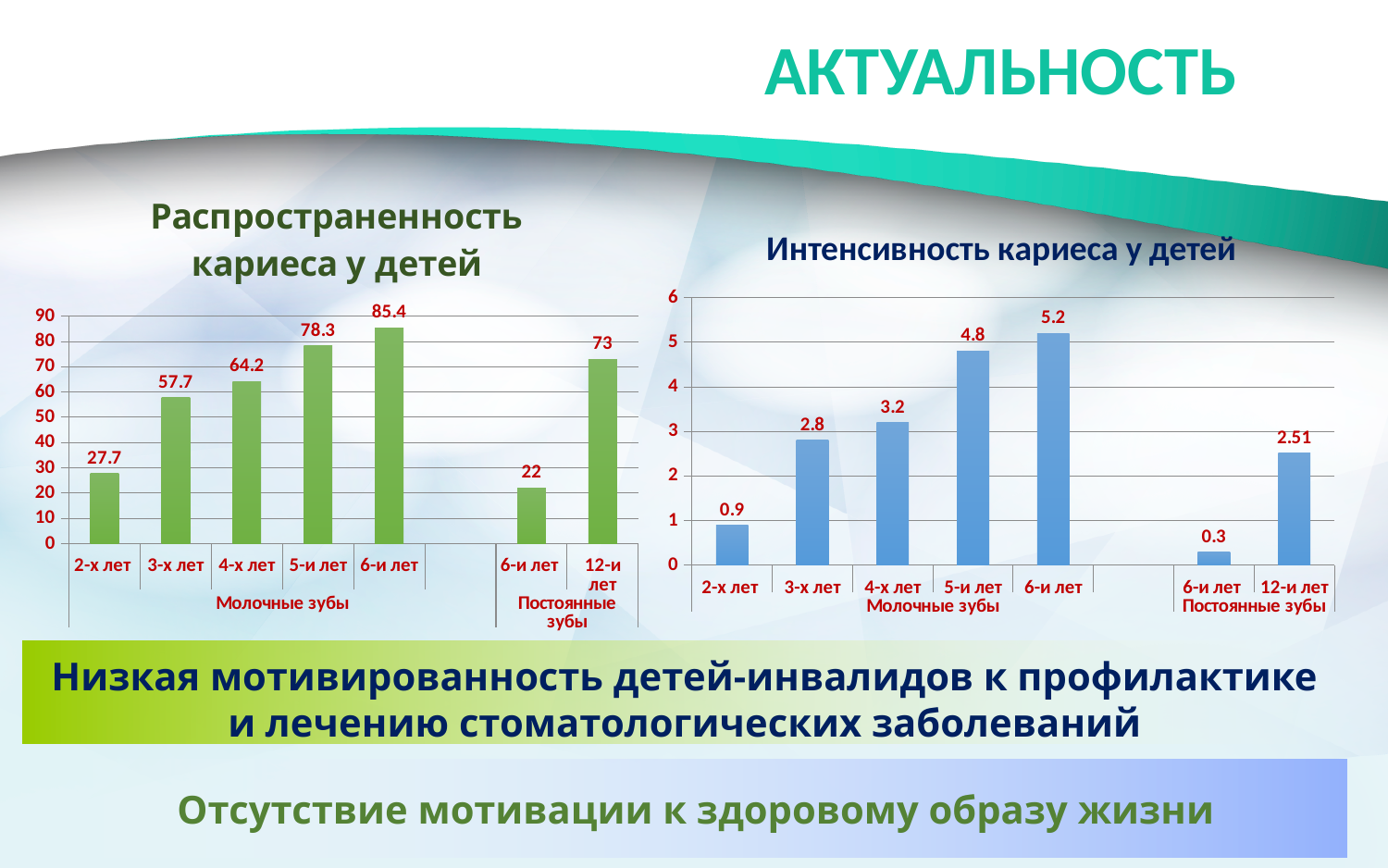
In the chart 'Распространенность кариеса у детей', which category has the highest value? 6-и лет (Молочные зубы) In the chart 'Распространенность кариеса у детей', what is the value for 4-х лет (Молочные зубы)? 64.2 What type of chart is 'Интенсивность кариеса у детей'? bar chart In the chart 'Распространенность кариеса у детей', which category has the lowest value? 6-и лет (Постоянные зубы) In the chart 'Распространенность кариеса у детей', how many bars are plotted? 7 In the chart 'Распространенность кариеса у детей', do the values for Молочные зубы rise or fall from 2-х лет to 6-и лет? rise In the chart 'Интенсивность кариеса у детей', which category has the lowest value? 6-и лет (Постоянные зубы) In the chart 'Интенсивность кариеса у детей', what is the value for 12-и лет (Постоянные зубы)? 2.51 In the chart 'Интенсивность кариеса у детей', what is the difference between the values for 6-и лет and 2-х лет (Молочные зубы)? 4.3 In the chart 'Распространенность кариеса у детей', what is the difference between the values for 12-и лет (Постоянные зубы) and 6-и лет (Постоянные зубы)? 51 In the chart 'Интенсивность кариеса у детей', what is the value for 3-х лет (Молочные зубы)? 2.8 In the chart 'Интенсивность кариеса у детей', which is larger: the value for 4-х лет or the value for 5-и лет (Молочные зубы)? 5-и лет